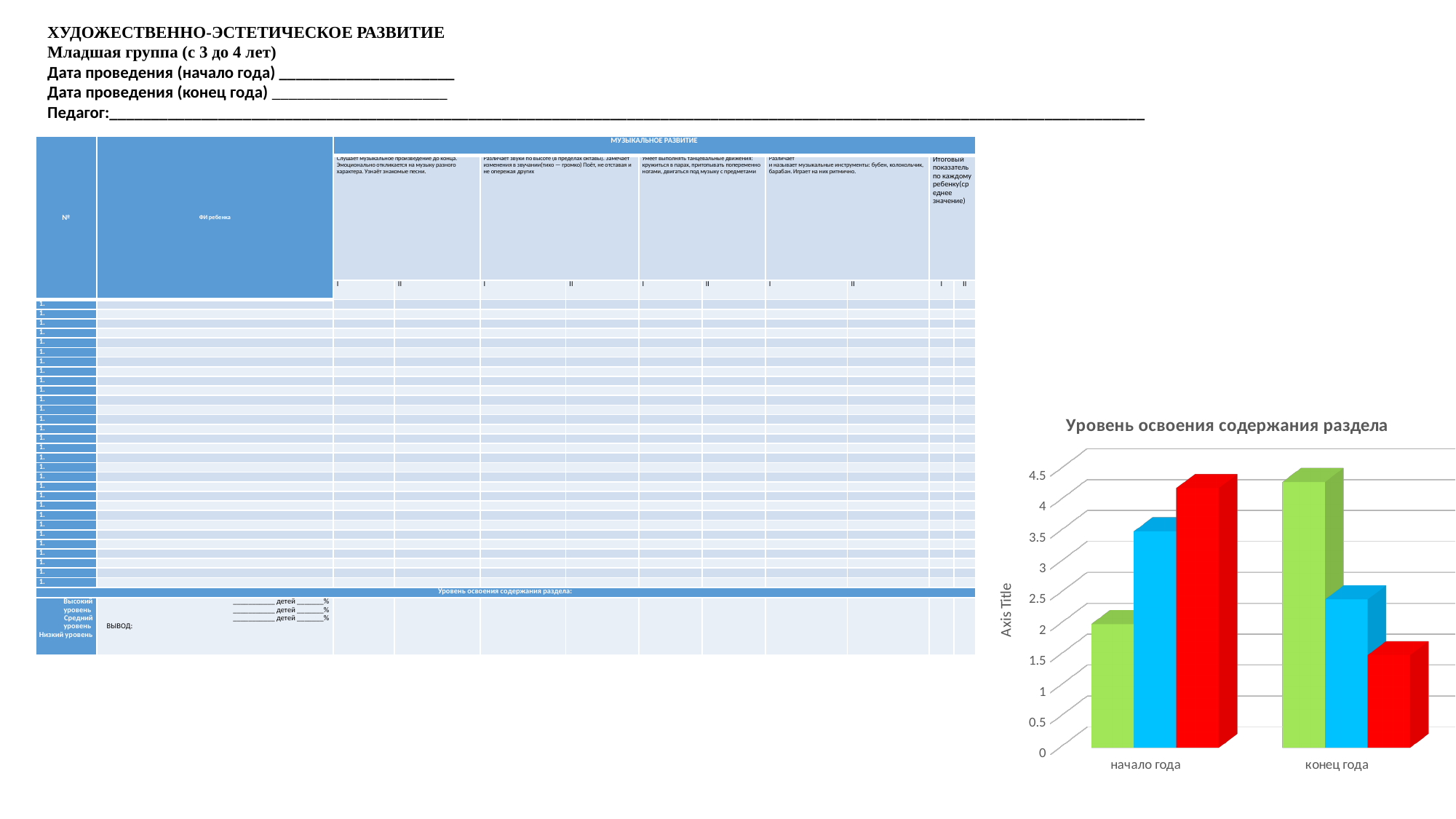
Which bar is the tallest for the category 'начало года'? the red bar Is the value of the green bar for 'конец года' greater or less than 3.5? greater Which is larger: the green bar for 'начало года' or the green bar for 'конец года'? the green bar for 'конец года' What kind of chart is shown on the slide? bar chart How many bars are plotted for the category 'начало года'? 3 What is the title of the chart on the slide? Уровень освоения содержания раздела Is the value of the red bar for 'конец года' greater or less than 2.5? less Which bar is the shortest for the category 'конец года'? the red bar How many categories are shown on the x axis of the chart? 2 What are the two category labels on the x axis of the chart? начало года, конец года Is the value of the green bar for 'начало года' greater or less than 3? less